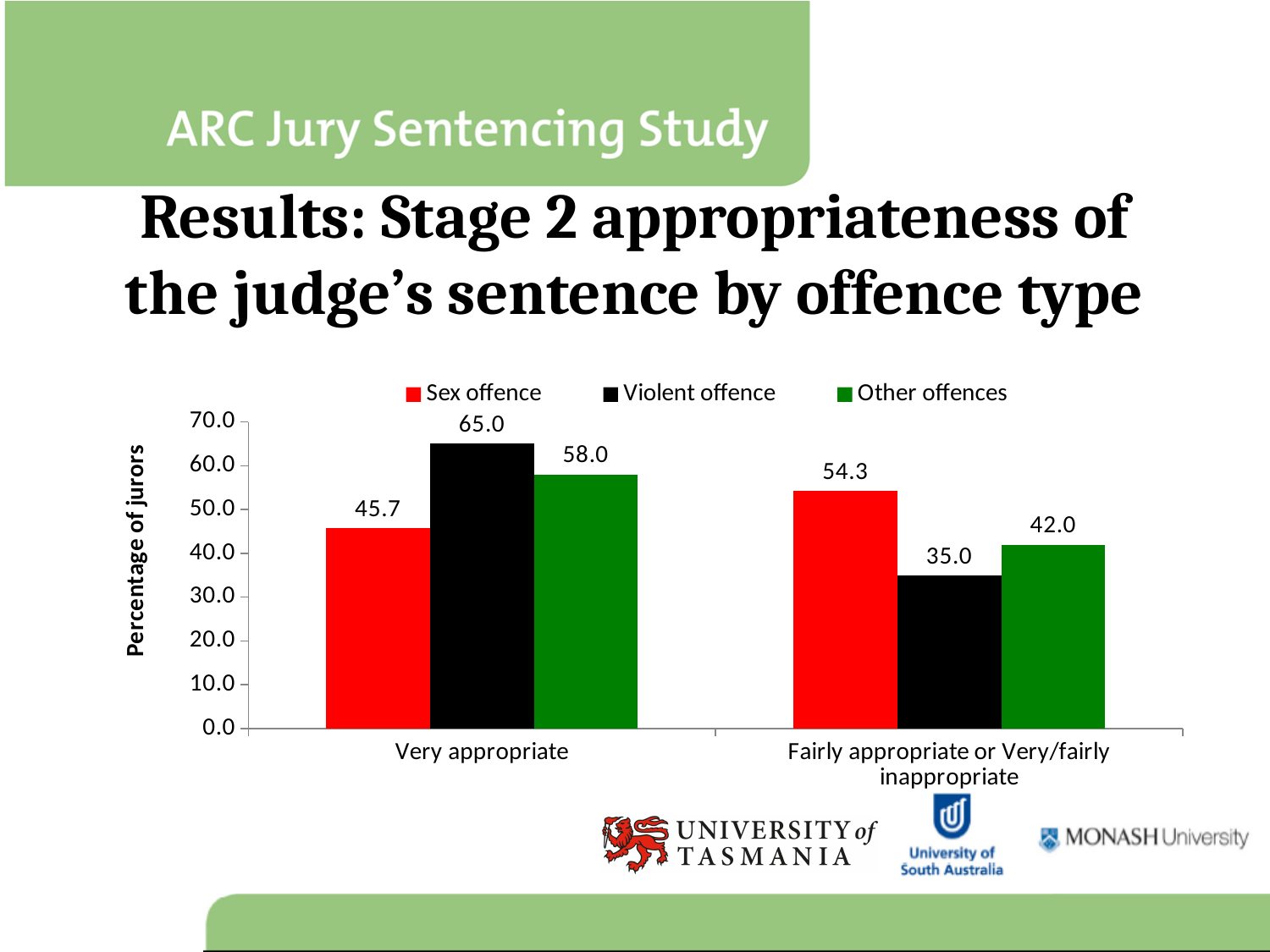
What is the difference between the Violent offence values for Very appropriate and Fairly appropriate or Very/fairly inappropriate? 30.0 Which series has the highest value in the Very appropriate category? Violent offence How many series does the legend list? 3 What is the value for Other offences in the Very appropriate category? 58.0 What is the value for Sex offence in the Very appropriate category? 45.7 What is the value for Violent offence in the Fairly appropriate or Very/fairly inappropriate category? 35.0 Which series has the lowest value in the Fairly appropriate or Very/fairly inappropriate category? Violent offence What kind of chart is shown on the slide? Bar chart How many categories are shown on the x axis? 2 Which is larger: the Sex offence value for Very appropriate or for Fairly appropriate or Very/fairly inappropriate? Fairly appropriate or Very/fairly inappropriate What is the label of the y axis? Percentage of jurors What colour represents Other offences in the chart? Green